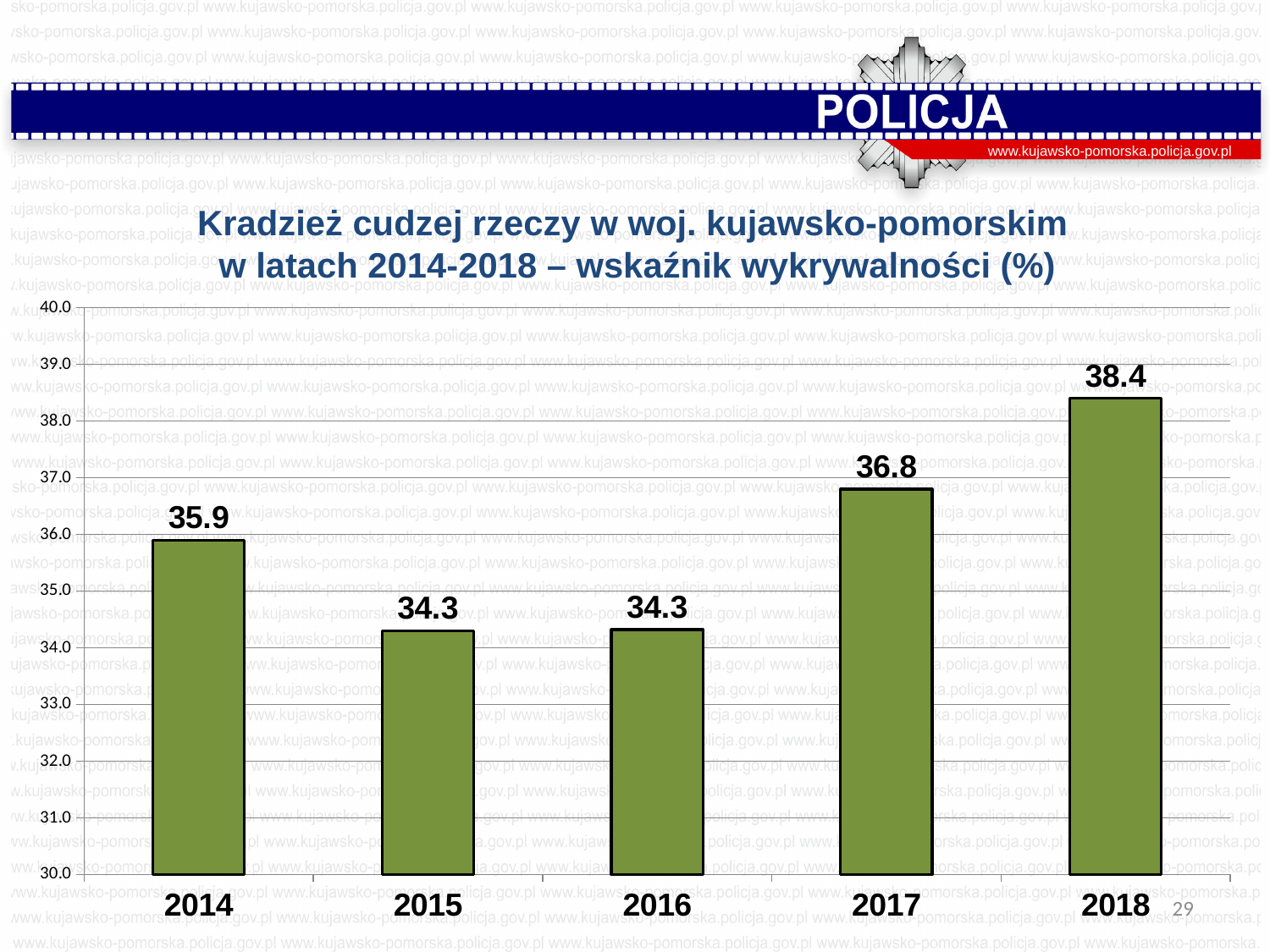
What is the value shown for 2017? 36.8 Which is larger, the value for 2014 or the value for 2017? 2017 Do the values rise or fall from 2016 to 2018? rise What is the difference between the values for 2014 and 2015? 1.6 Which year has the highest value? 2018 What is the detection rate value shown for 2014? 35.9 What is the difference between the values for 2018 and 2017? 1.6 What is the title of the chart? Kradzież cudzej rzeczy w woj. kujawsko-pomorskim w latach 2014-2018 – wskaźnik wykrywalności (%) How many years are shown on the x axis? 5 What is the value shown for 2018? 38.4 What kind of chart is shown on the slide? bar chart Is the value for 2016 greater or less than 35.0? less